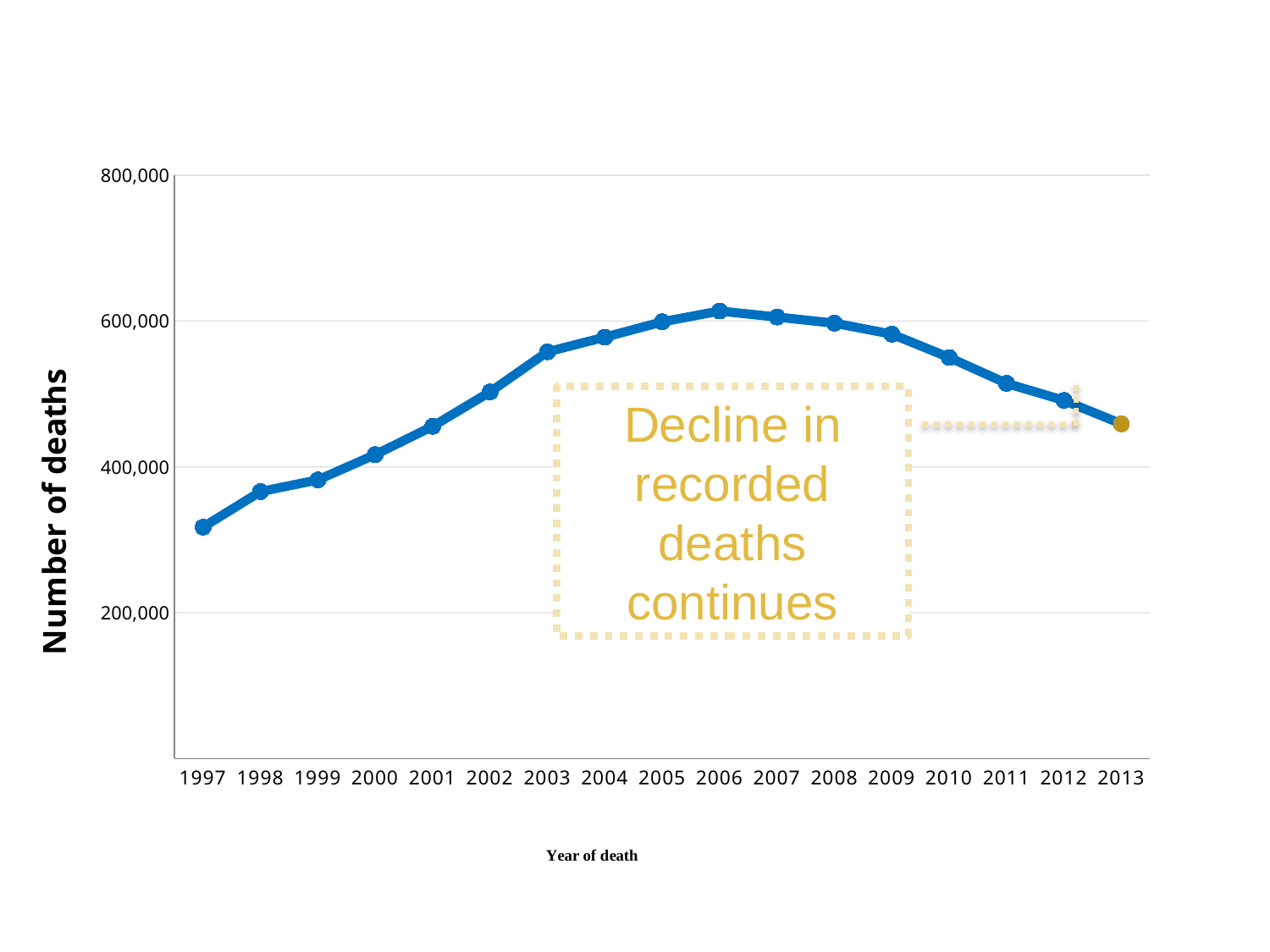
Is the number of deaths in 2006 greater or less than 600,000? greater What kind of chart is shown on the slide? line chart How many years are plotted along the x axis? 17 Which year has the lowest number of deaths? 1997 Is the number of deaths in 2010 greater or less than 600,000? less What is the label on the vertical axis? Number of deaths Which year has more recorded deaths, 2001 or 2011? 2011 Which year has the highest number of deaths? 2006 Do the values rise or fall between 1997 and 2006? rise Is the number of deaths in 1997 greater or less than 400,000? less Do the values rise or fall between 2006 and 2013? fall